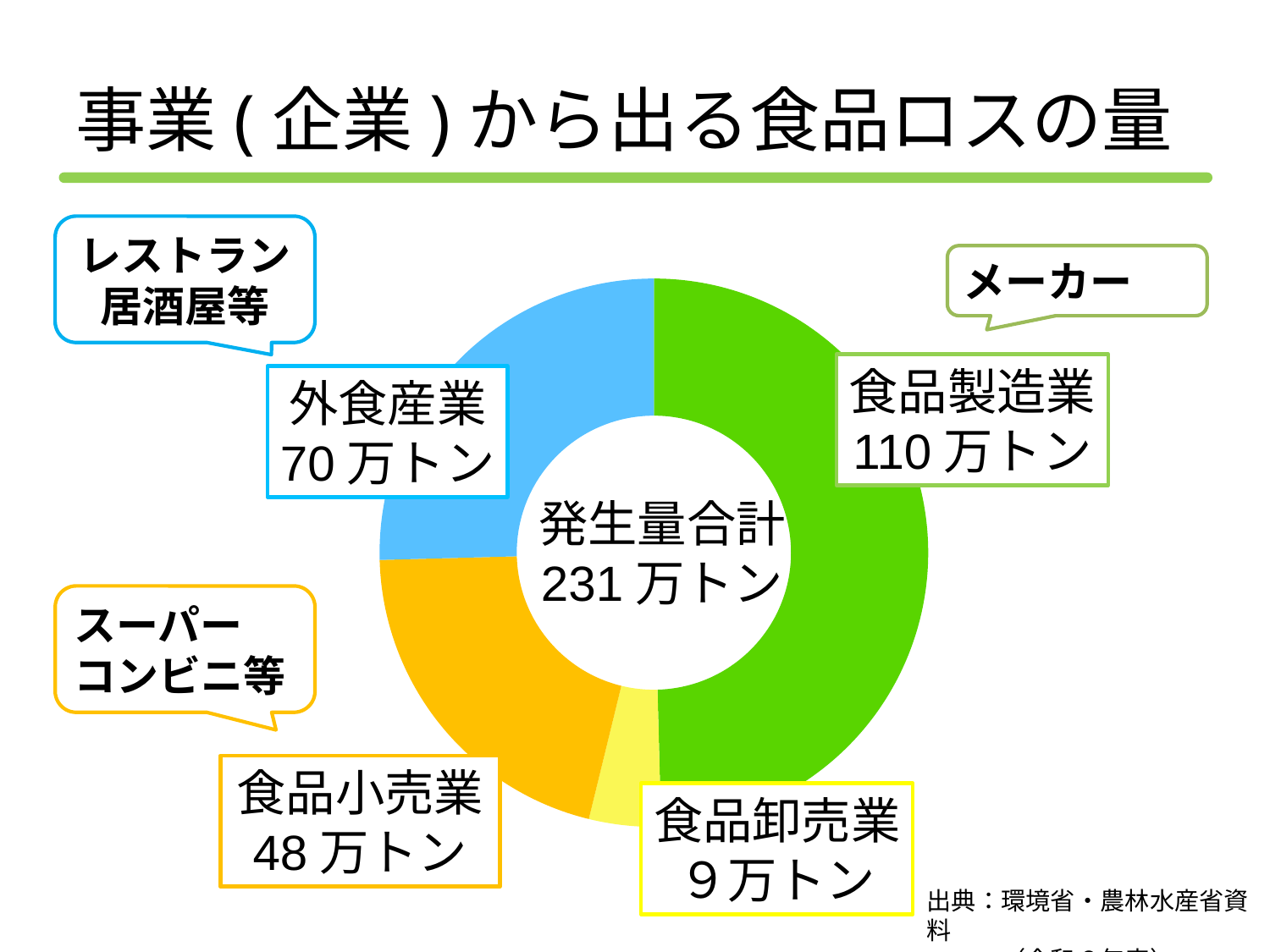
What is the value for 外食産業 in the chart? 70万トン What is the value for 食品卸売業 in the chart? 9万トン What is the total amount (発生量合計) shown in the centre of the chart? 231万トン Which is larger, the value for 外食産業 or the value for 食品小売業? 外食産業 What is the value for 食品製造業 in the chart? 110万トン What is the difference between the values for 食品製造業 and 外食産業? 40万トン How many categories are shown in the chart? 4 Which category has the highest value in the chart? 食品製造業 What is the difference between the values for 食品小売業 and 食品卸売業? 39万トン What is the value for 食品小売業 in the chart? 48万トン What kind of chart is shown on the slide? Donut (pie) chart Which category has the lowest value in the chart? 食品卸売業